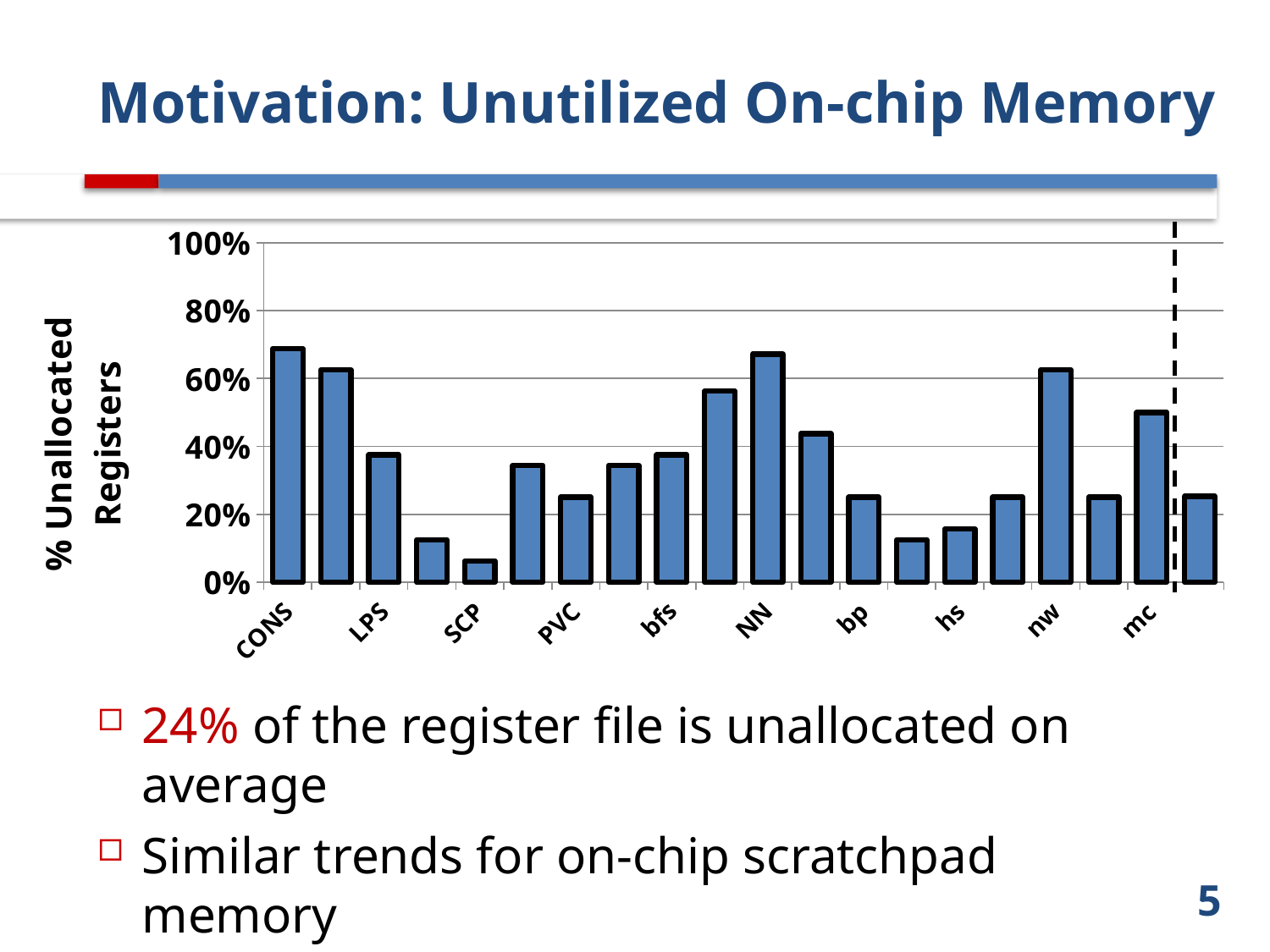
Is the value for NN greater or less than 60%? greater Is the value for LPS greater or less than 60%? less Which has a higher percentage of unallocated registers, PVC or mc? mc How many category labels are printed along the x axis of the chart? 10 Which labeled category has the lowest percentage of unallocated registers? SCP Is the value for CONS greater or less than 60%? greater Which has a higher percentage of unallocated registers, NN or hs? NN What is the title of the y axis of the chart? % Unallocated Registers What kind of chart is shown on the slide? bar chart